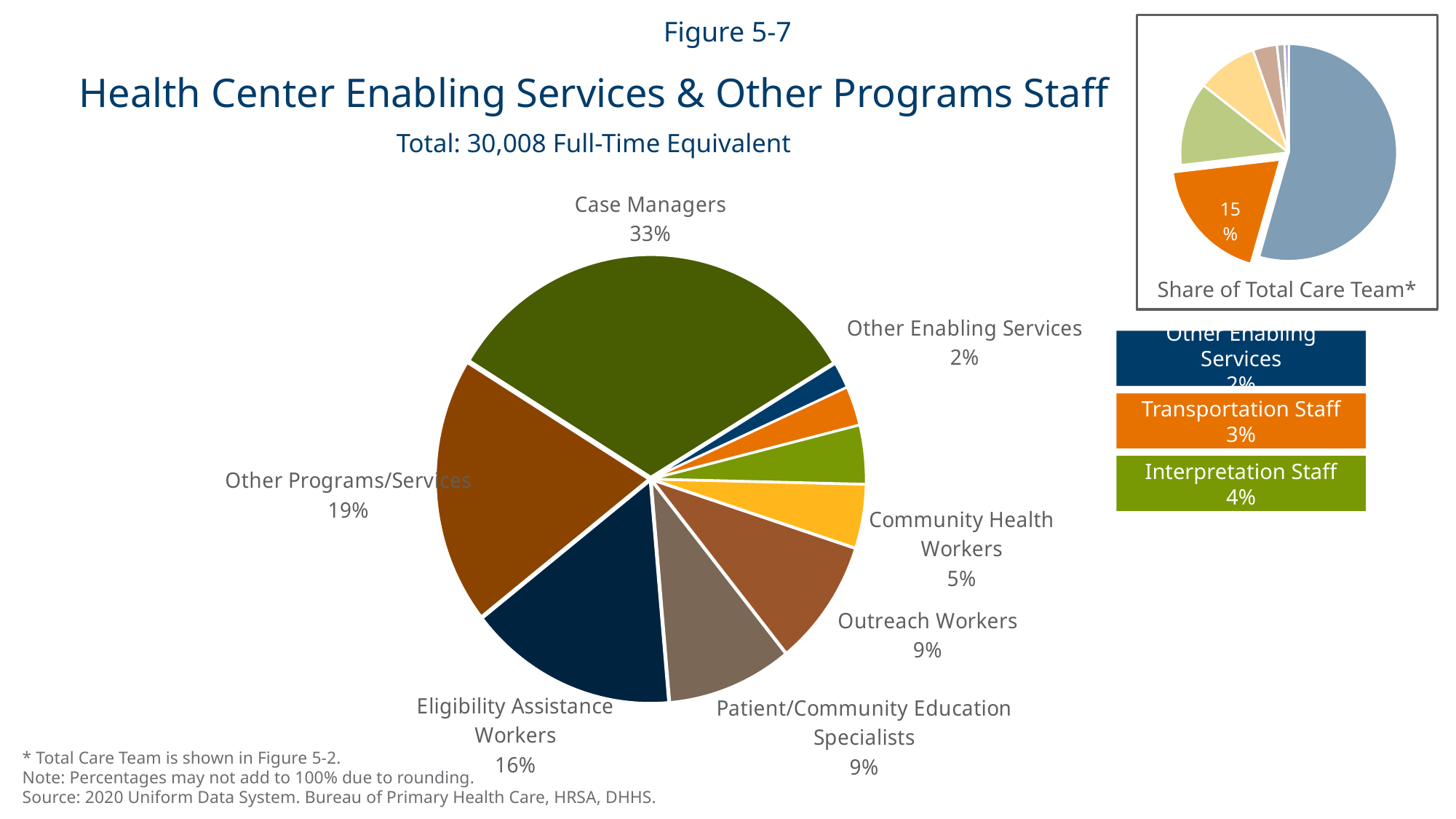
In the main pie chart, what percentage of staff are Community Health Workers? 5% In the main pie chart, what percentage of staff are Eligibility Assistance Workers? 16% In the main pie chart, what is the difference in percentage points between Case Managers and Other Programs/Services? 14 In the main pie chart, what percentage of staff are Transportation Staff? 3% How many categories are shown in the main pie chart? 9 In the main pie chart, which category has the largest share? Case Managers In the main pie chart, what percentage of staff are Case Managers? 33% In the main pie chart, which category has the smallest share? Other Enabling Services What total number of full-time equivalents is stated in the subtitle of the main chart? 30,008 In the main pie chart, which is larger: Eligibility Assistance Workers or Outreach Workers? Eligibility Assistance Workers In the inset chart titled 'Share of Total Care Team*', what percentage is labeled on the orange slice? 15% What kind of chart is the main chart on the slide? Pie chart